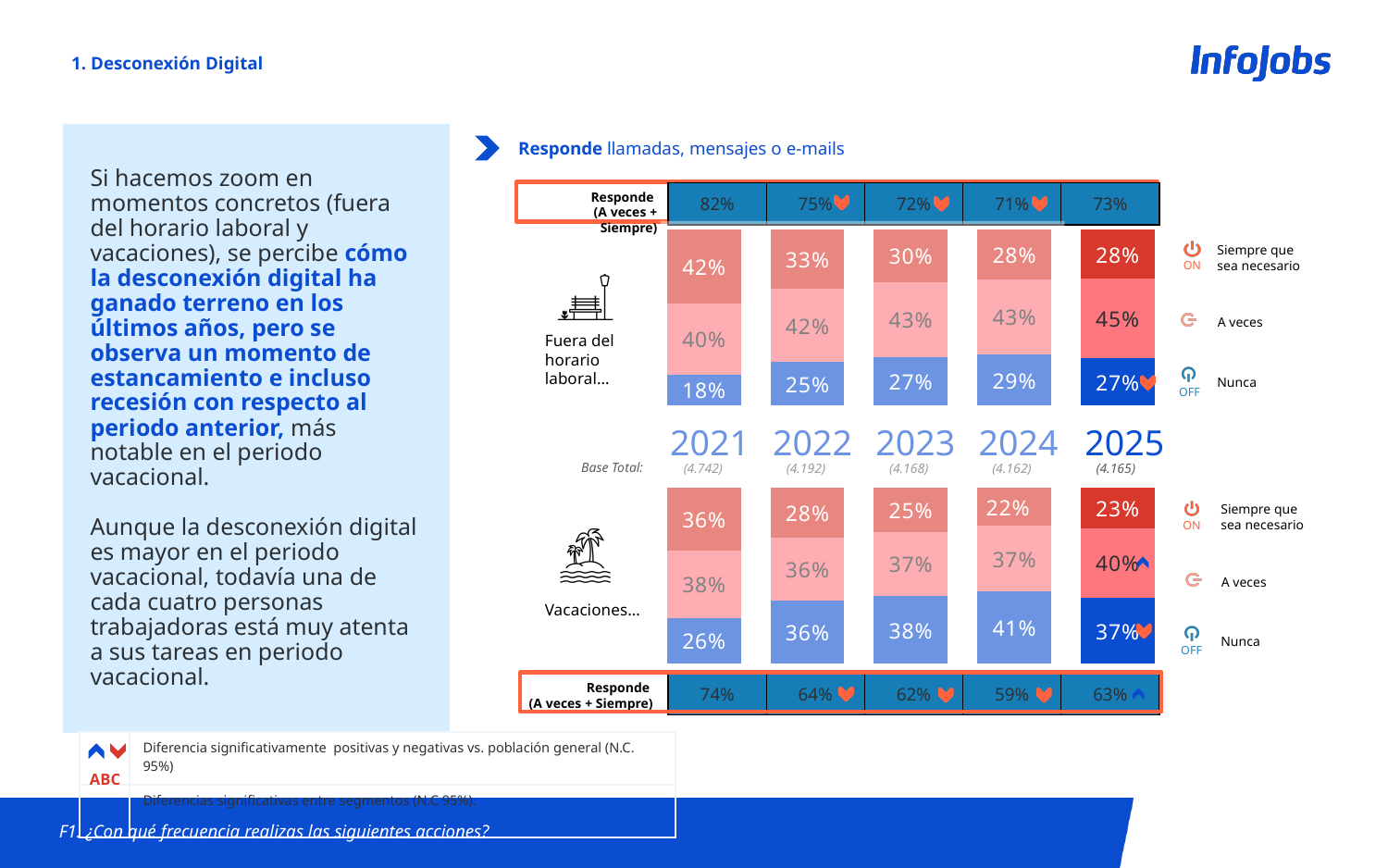
In the 'Fuera del horario laboral' chart, which year has the lowest 'Nunca' value? 2021 In the 'Fuera del horario laboral' chart, what is the 'Responde (A veces + Siempre)' value for 2021? 82% In the 'Fuera del horario laboral' chart, what is the difference between the 'Siempre que sea necesario' values for 2021 and 2025? 14 percentage points How many series does the legend list for each chart? 3 In the 'Vacaciones' chart, which year has the highest 'Nunca' value? 2024 In the 'Vacaciones' chart for 2025, which is larger: 'A veces' or 'Nunca'? A veces How many years are shown on the x axis of the charts? 5 In the 'Fuera del horario laboral' chart, what is the value for 'Nunca' in 2025? 27% What kind of chart is used to show the 'Fuera del horario laboral' and 'Vacaciones' data? Stacked bar chart In the 'Vacaciones' chart, what is the value for 'Nunca' in 2024? 41% In the 'Vacaciones' chart, what is the 'Responde (A veces + Siempre)' value for 2024? 59% In the 'Fuera del horario laboral' chart, does the 'Siempre que sea necesario' value rise or fall from 2021 to 2024? Fall